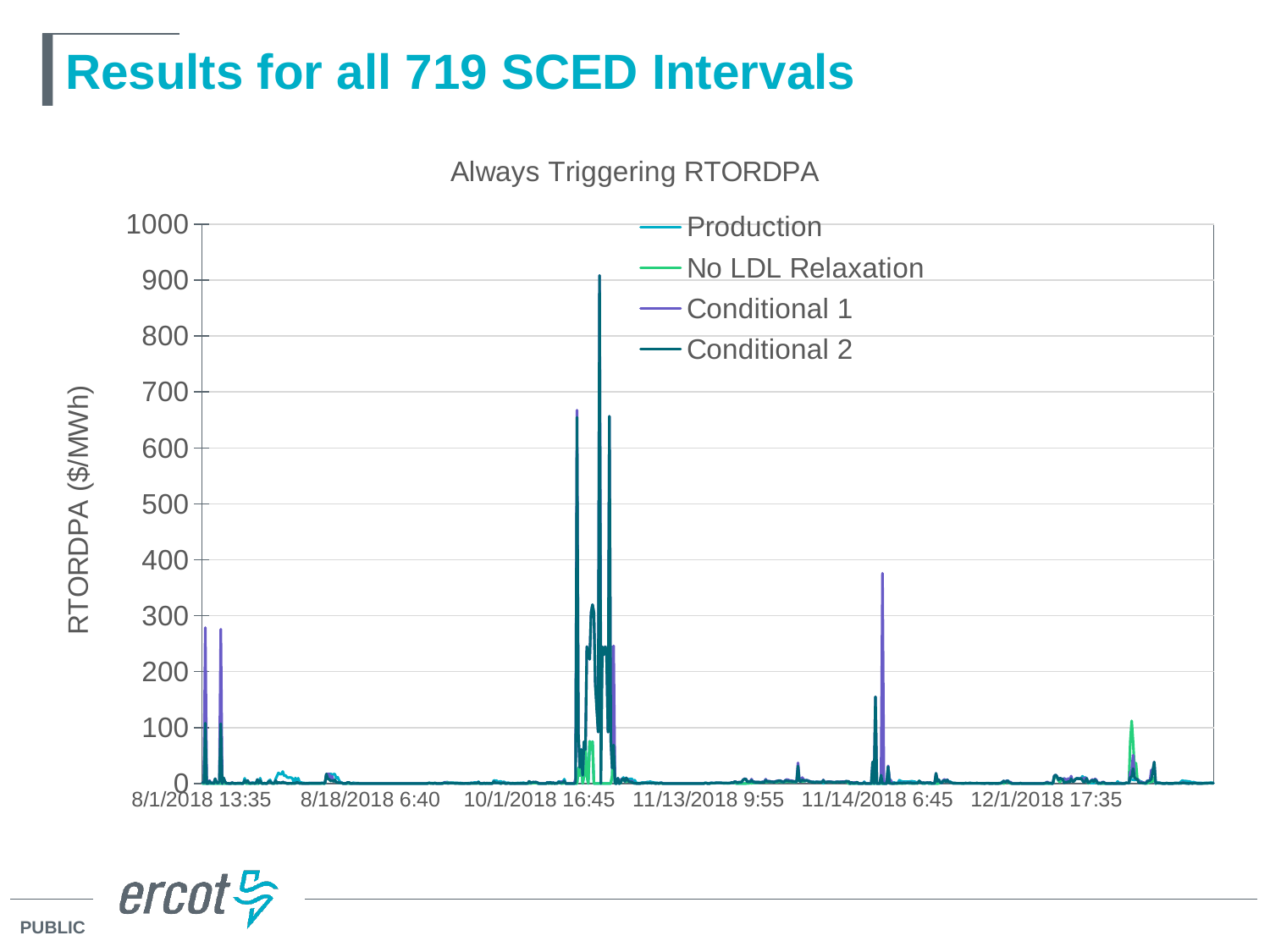
What is the highest value shown on the vertical axis? 1000 How many date labels are shown along the horizontal axis? 6 Is the tallest spike on the chart, near 10/1/2018 16:45, greater or less than 800? greater Is the Conditional 1 spike near 11/14/2018 6:45 greater or less than 300? greater Is the No LDL Relaxation spike near 12/1/2018 17:35 greater or less than 200? less What is the title of the chart? Always Triggering RTORDPA How many series does the legend list? 4 What is the label of the vertical axis? RTORDPA ($/MWh) What kind of chart is shown on the slide? line chart